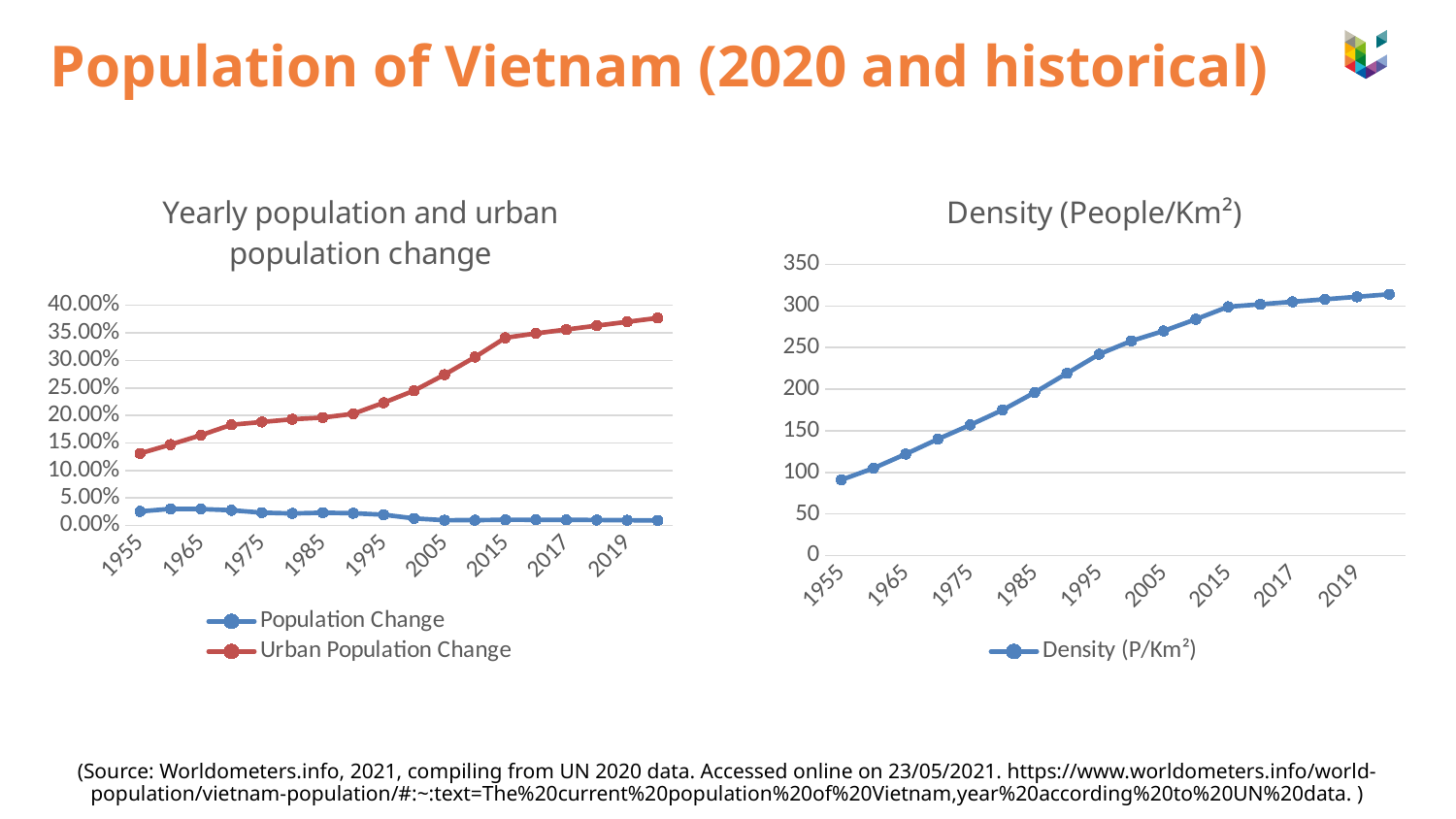
In the 'Yearly population and urban population change' chart, does the Urban Population Change series rise or fall from 1955 to 2019? rise In the 'Yearly population and urban population change' chart, is the Urban Population Change for 1955 greater or less than 10.00%? greater What kind of chart is the 'Yearly population and urban population change' chart? line chart In the 'Density (People/Km²)' chart, which year shown on the x axis has the lowest density? 1955 How many series does the legend of the 'Yearly population and urban population change' chart list? 2 In the 'Yearly population and urban population change' chart, is the Population Change for 1955 greater or less than 5.00%? less In the 'Yearly population and urban population change' chart, which series has the higher value in 2019, Population Change or Urban Population Change? Urban Population Change In the 'Density (People/Km²)' chart, is the density for 2019 greater or less than 300? greater How many series does the legend of the 'Density (People/Km²)' chart list? 1 In the 'Density (People/Km²)' chart, does the density rise or fall from 1955 to 2019? rise What kind of chart is the 'Density (People/Km²)' chart? line chart